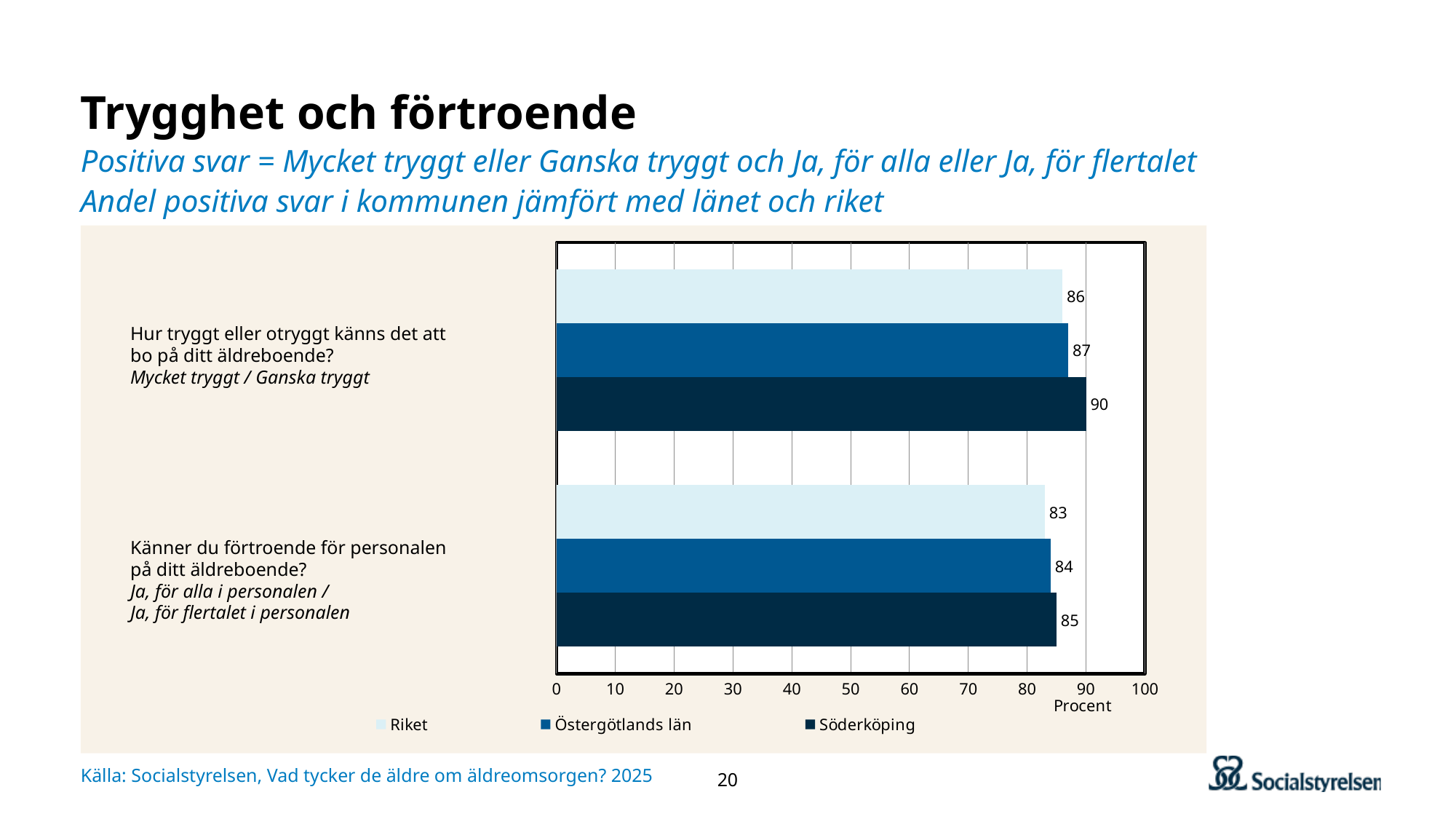
What is the difference between Söderköping and Riket on the question "Hur tryggt eller otryggt känns det att bo på ditt äldreboende?"? 4 Which is larger: Söderköping's value for the trygghet question or Söderköping's value for the förtroende question? The trygghet question (90) What is the value for Söderköping on the question "Hur tryggt eller otryggt känns det att bo på ditt äldreboende?"? 90 Which series has the highest value on the question "Hur tryggt eller otryggt känns det att bo på ditt äldreboende?"? Söderköping How many series does the legend list? 3 What is the value for Riket on the question "Känner du förtroende för personalen på ditt äldreboende?"? 83 What kind of chart is shown on the slide? Bar chart How many questions (categories) are shown on the chart? 2 What is the value for Östergötlands län on the question "Känner du förtroende för personalen på ditt äldreboende?"? 84 What is the difference between Söderköping and Riket on the question "Känner du förtroende för personalen på ditt äldreboende?"? 2 What is the value for Östergötlands län on the question "Hur tryggt eller otryggt känns det att bo på ditt äldreboende?"? 87 Which series has the lowest value on the question "Känner du förtroende för personalen på ditt äldreboende?"? Riket